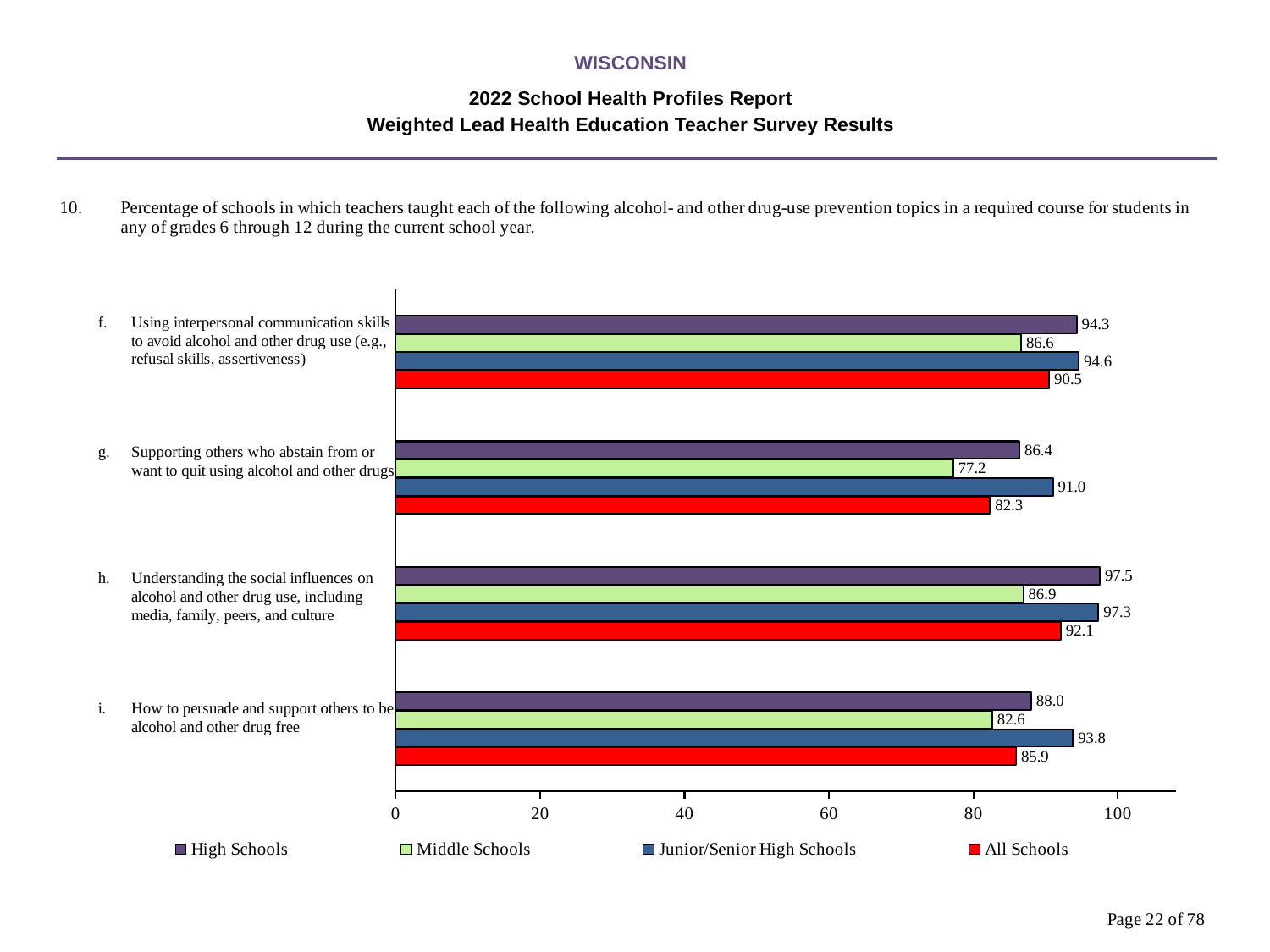
What kind of chart is shown on the slide? Bar chart What is the value for Middle Schools for topic g (Supporting others who abstain from or want to quit using alcohol and other drugs)? 77.2 What is the value for All Schools for topic i (How to persuade and support others to be alcohol and other drug free)? 85.9 What is the value for Junior/Senior High Schools for topic f (Using interpersonal communication skills to avoid alcohol and other drug use)? 94.6 What is the value for High Schools for topic h (Understanding the social influences on alcohol and other drug use)? 97.5 Which topic has the lowest value for All Schools? g. Supporting others who abstain from or want to quit using alcohol and other drugs How many topics (categories) are shown on the chart? 4 What is the difference between the Junior/Senior High Schools value and the Middle Schools value for topic i? 11.2 For topic g, which is larger: the High Schools value or the Junior/Senior High Schools value? Junior/Senior High Schools How many series does the legend list? 4 Which topic has the highest value for Middle Schools? h. Understanding the social influences on alcohol and other drug use, including media, family, peers, and culture Which series is shown in red in the legend? All Schools